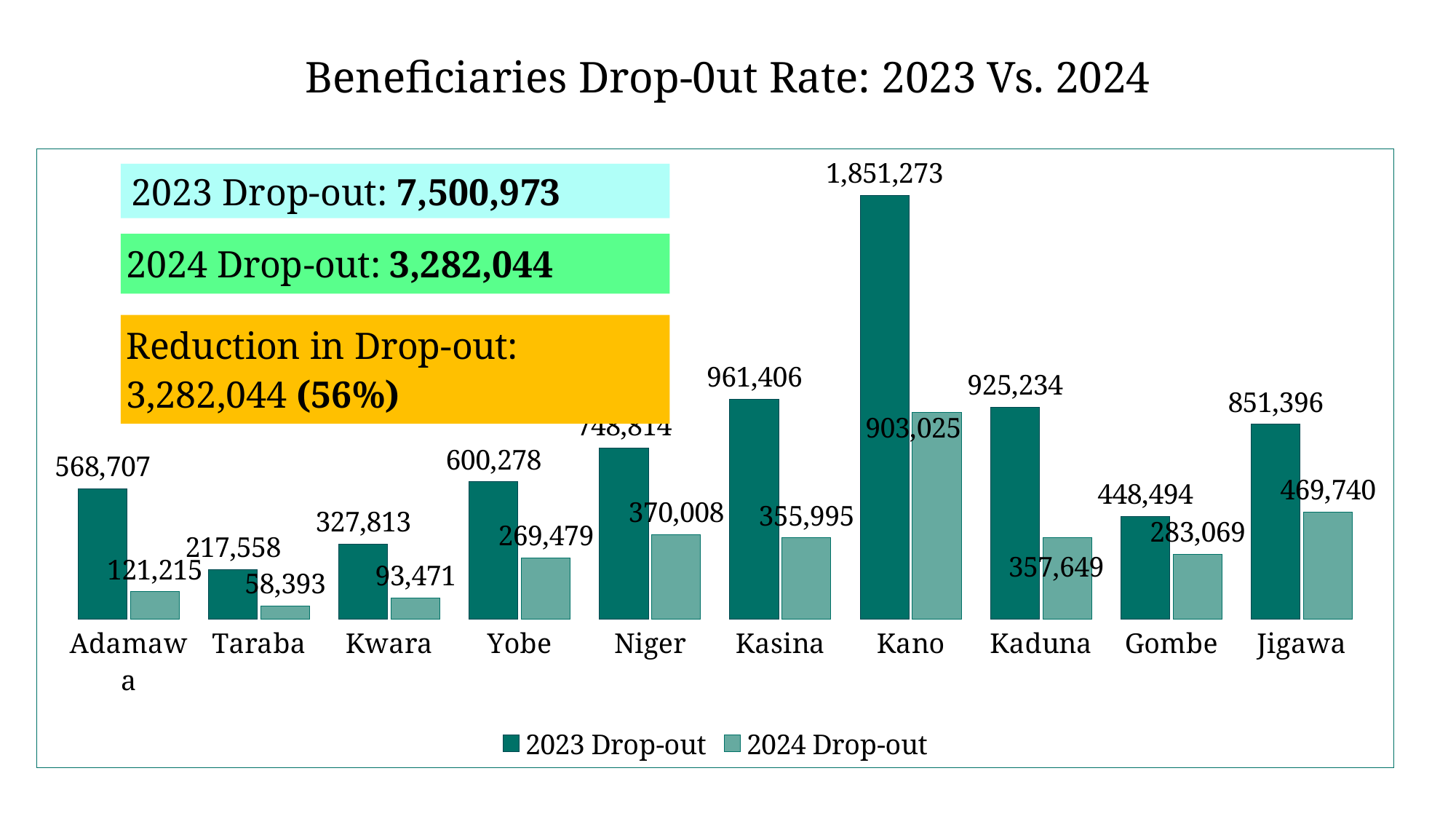
How many series does the legend list? 2 Which is larger, the 2023 Drop-out for Kasina or the 2023 Drop-out for Kaduna? Kasina What is the 2024 Drop-out value for Taraba? 58,393 How many states are shown on the x axis of the chart? 10 What is the 2024 Drop-out value for Jigawa? 469,740 Which is larger, the 2024 Drop-out for Gombe or the 2024 Drop-out for Kwara? Gombe Which state has the highest 2023 Drop-out value? Kano What is the difference between the 2023 Drop-out and 2024 Drop-out values for Adamawa? 447,492 Which state has the lowest 2024 Drop-out value? Taraba What is the difference between the 2023 Drop-out and 2024 Drop-out values for Kano? 948,248 What kind of chart is shown on the slide? Bar chart What is the 2023 Drop-out value for Kano? 1,851,273